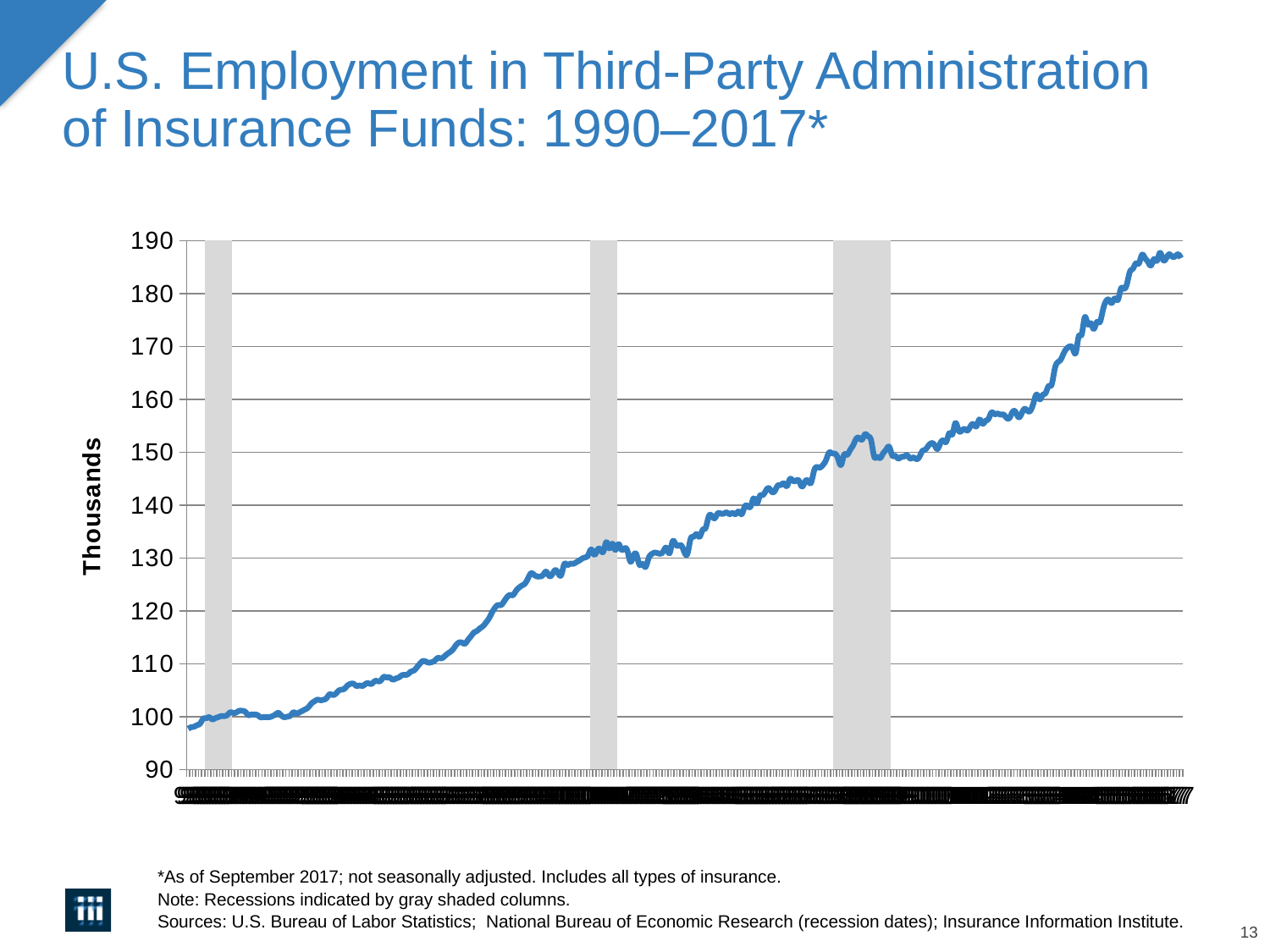
Overall, do the values rise or fall from left to right along the x axis? rise Where along the x axis does the line reach its highest value: at the left end or at the right end? right end Is the value at the left end of the line (the start of the series) greater or less than 110? less What is the title of the chart? U.S. Employment in Third-Party Administration of Insurance Funds: 1990–2017* Is the value of the line during the third gray shaded recession column greater or less than 160? less What is the label on the vertical axis of the chart? Thousands Is the value of the line during the second gray shaded recession column greater or less than 140? less How many gray shaded recession columns are shown on the chart? 3 Where along the x axis does the line reach its lowest value: at the left end or at the right end? left end What kind of chart is shown on the slide? line chart